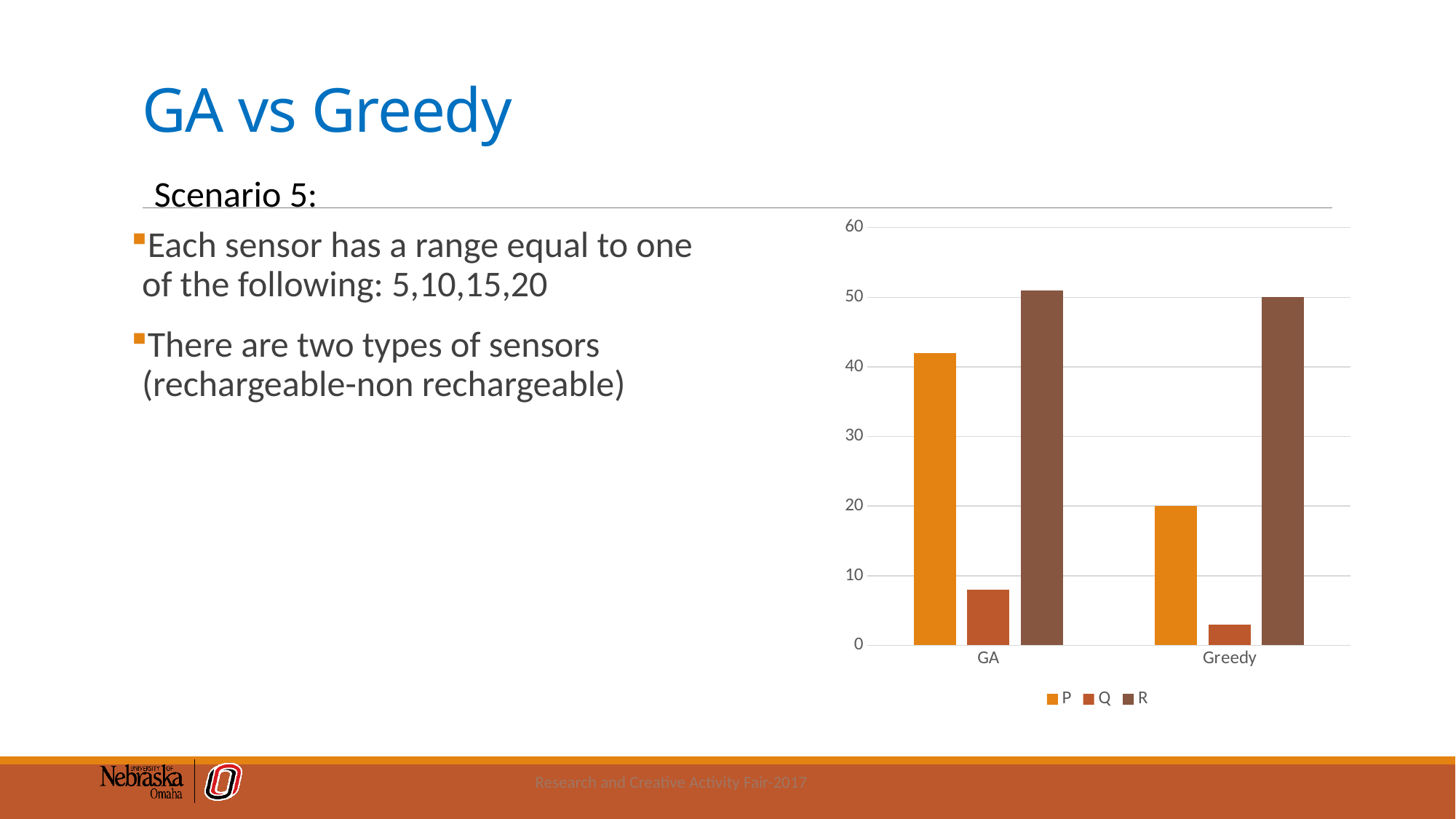
How many categories are shown on the x axis of the chart? 2 Is the value of Q for Greedy greater or less than 10? less Is the value of Q for GA greater or less than 10? less Which is larger, the value of P for GA or the value of P for Greedy? P for GA Which is larger, the value of Q for GA or the value of Q for Greedy? Q for GA Is the value of P for GA greater or less than 40? greater How many series does the chart legend list? 3 What kind of chart is shown on the slide? bar chart What are the names of the series listed in the chart legend? P, Q, R Which series has the lowest value for Greedy? Q Which series has the highest value for GA? R